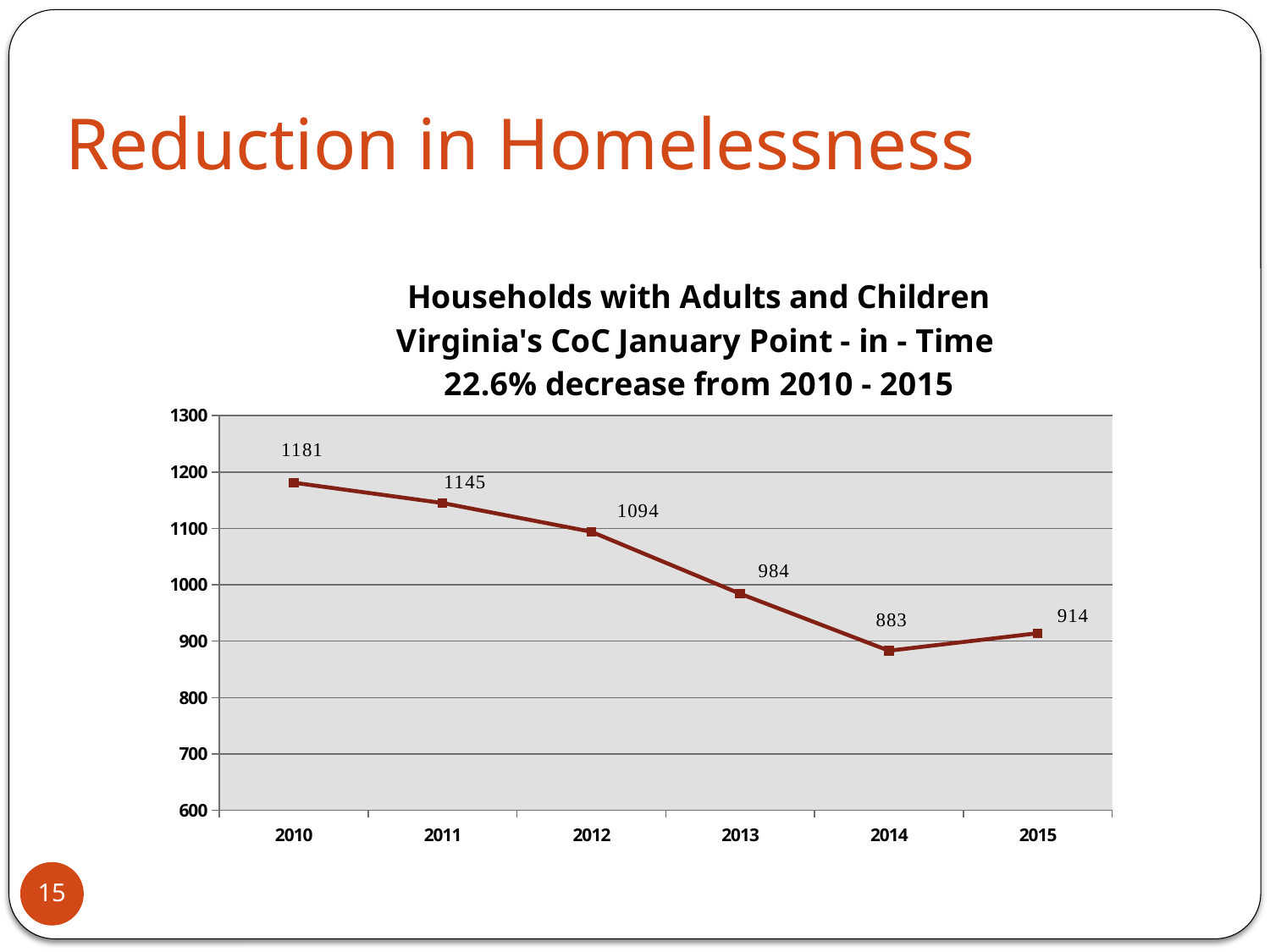
Which year has the highest value? 2010 What is the difference between the values for 2010 and 2015? 267 Which year has the lowest value? 2014 What kind of chart is shown on the slide? line chart What is the value for 2015? 914 What is the value for 2014? 883 Which is larger, the value for 2011 or the value for 2013? 2011 What is the difference between the values for 2012 and 2013? 110 What percentage decrease from 2010 to 2015 does the chart title state? 22.6% Is the value for 2013 greater or less than 1000? less What is the value for 2010? 1181 How many years are plotted on the chart? 6